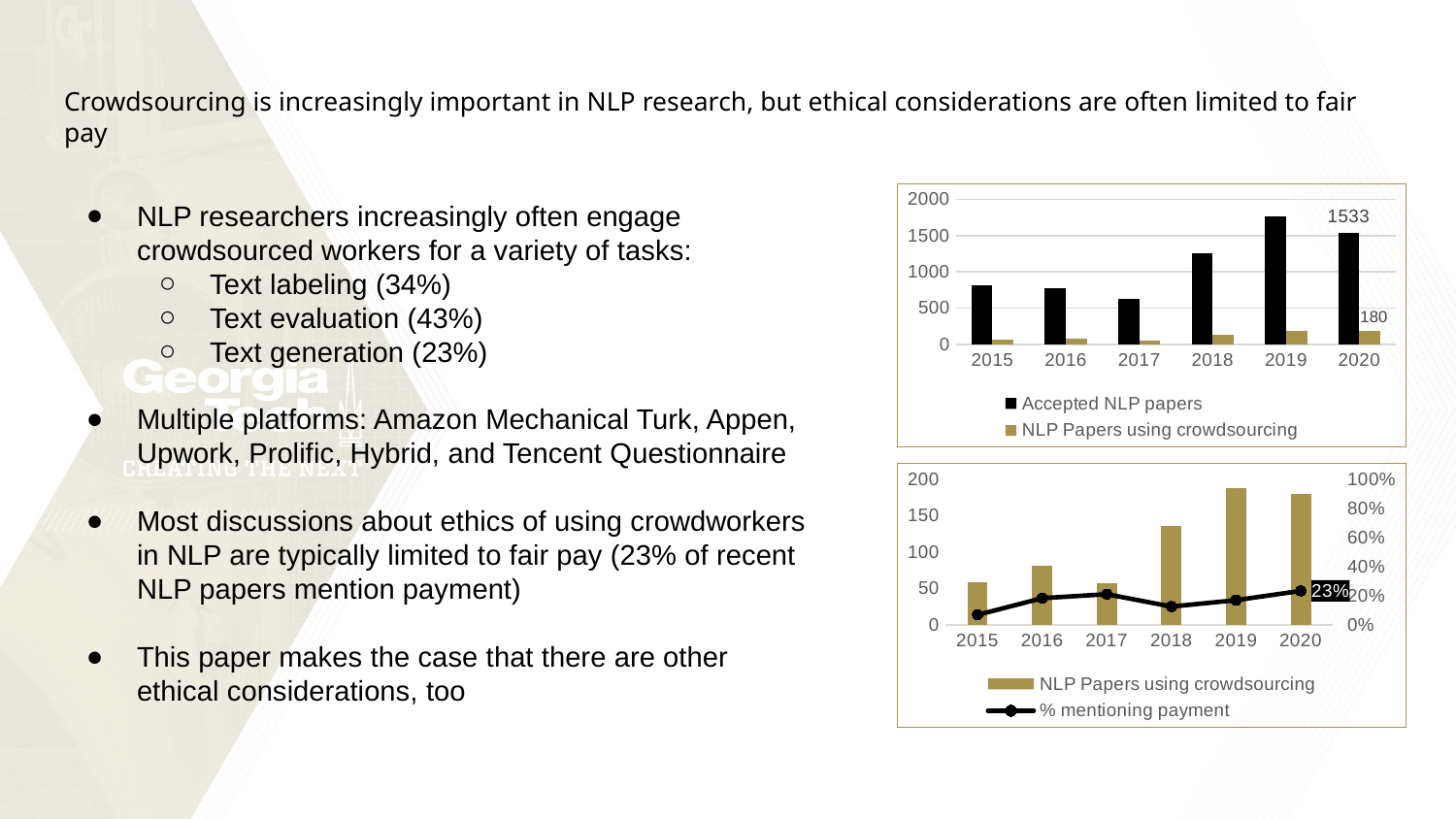
In the top chart, is the value for Accepted NLP papers in 2018 greater or less than 1000? greater In the bottom chart, what is the % mentioning payment value labeled for 2020? 23% In the top chart, how many years are shown on the x axis? 6 In the top chart, how many series does the legend list? 2 In the top chart, which year has the lowest number of Accepted NLP papers? 2017 In the top chart, is the value for Accepted NLP papers in 2019 greater or less than 1500? greater In the top chart, what is the value for Accepted NLP papers in 2020? 1533 In the top chart, what is the value for NLP Papers using crowdsourcing in 2020? 180 In the bottom chart, which series is drawn as a line? % mentioning payment In the top chart, which year has the highest number of Accepted NLP papers? 2019 In the bottom chart, is the value for NLP Papers using crowdsourcing in 2018 greater or less than 100? greater In the bottom chart, which year has the highest number of NLP Papers using crowdsourcing? 2019